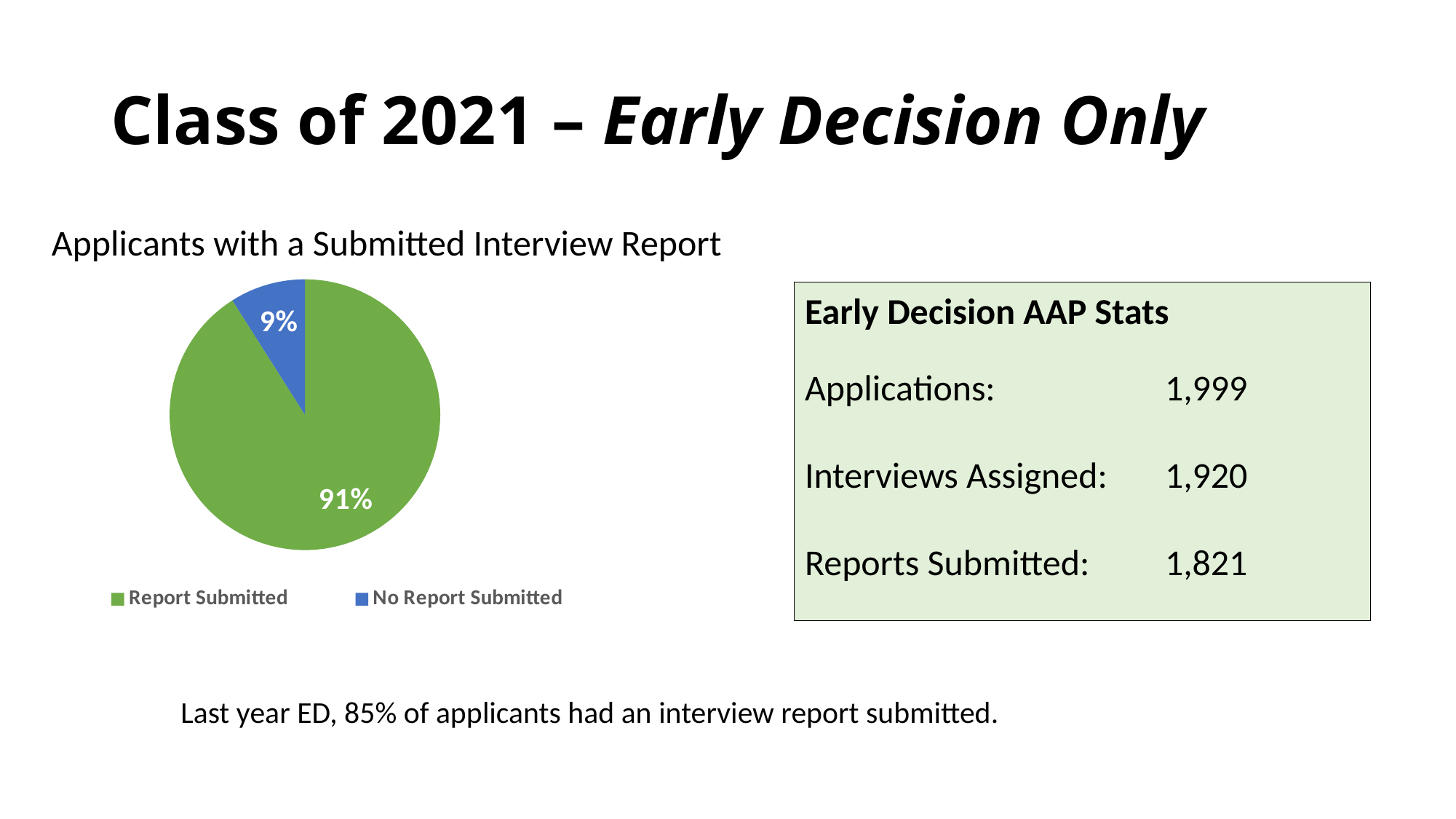
What share of the pie does Report Submitted take? 91% How many entries does the legend list? 2 What colour is the No Report Submitted slice? blue What is the title of the pie chart? Applicants with a Submitted Interview Report What kind of chart is shown on the slide? pie chart How many slices does the pie chart have? 2 Which slice of the pie is the smallest? No Report Submitted Which slice of the pie is the largest? Report Submitted Which is larger, the Report Submitted slice or the No Report Submitted slice? Report Submitted What is the difference in percentage points between the Report Submitted and No Report Submitted slices? 82 What share of the pie does No Report Submitted take? 9%